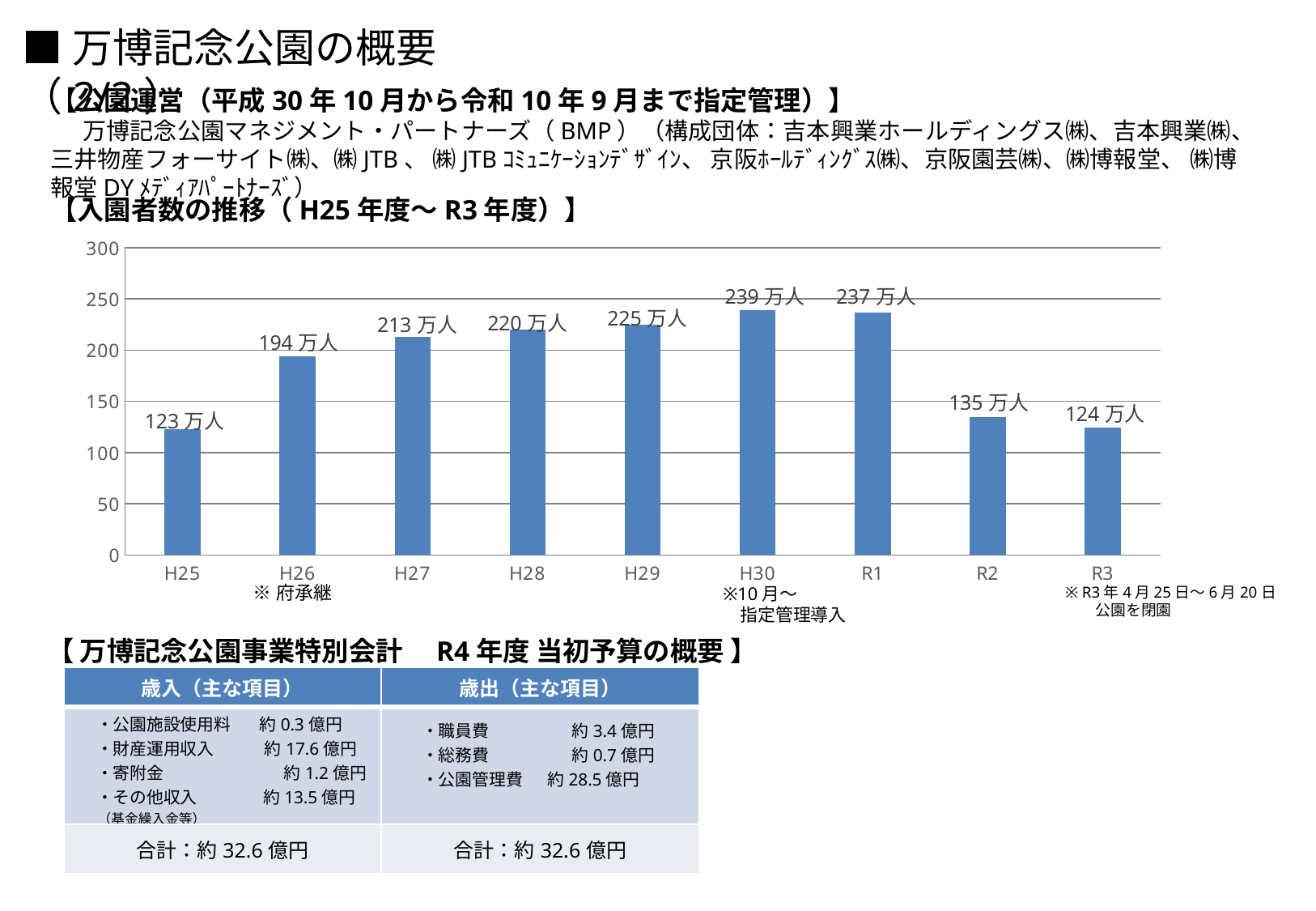
Which fiscal year has the highest number of visitors? H30 What is the number of visitors for H30? 239万人 Is the value for H26 greater or less than 150? greater What is the number of visitors for H25? 123万人 What is the maximum value shown on the vertical axis of the chart? 300 What is the number of visitors for R3? 124万人 What kind of chart is used to show the visitor numbers? bar chart How many fiscal years are shown on the x axis of the chart? 9 Which has more visitors, H27 or R1? R1 Do the visitor numbers rise or fall from H25 to H30? rise Which fiscal year has the lowest number of visitors? H25 What is the difference in visitors between H30 and R2? 104万人